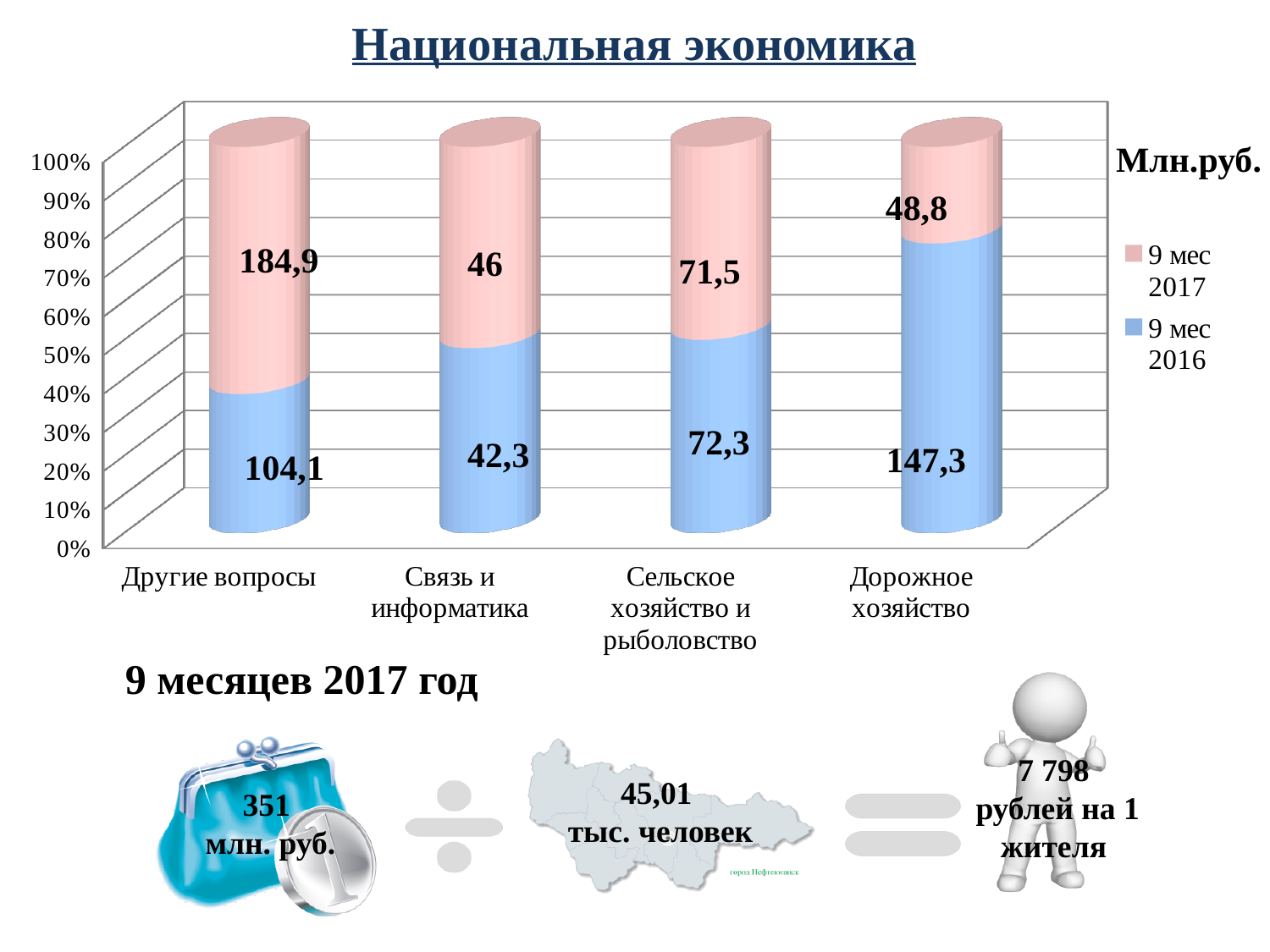
How many categories are shown on the x axis of the chart? 4 For Дорожное хозяйство, which series has the larger value, 9 мес 2017 or 9 мес 2016? 9 мес 2016 How many series does the chart legend list? 2 Which category has the highest value in the 9 мес 2017 series? Другие вопросы What is the difference between the 9 мес 2016 and 9 мес 2017 values for Дорожное хозяйство? 98,5 What is the value for Связь и информатика in the 9 мес 2017 series? 46 What is the value for Дорожное хозяйство in the 9 мес 2016 series? 147,3 What is the value for Сельское хозяйство и рыболовство in the 9 мес 2016 series? 72,3 Which category has the lowest value in the 9 мес 2016 series? Связь и информатика What is the difference between the 9 мес 2017 and 9 мес 2016 values for Другие вопросы? 80,8 What kind of chart is shown on the slide? Stacked bar chart What is the total of the two series for Связь и информатика? 88,3